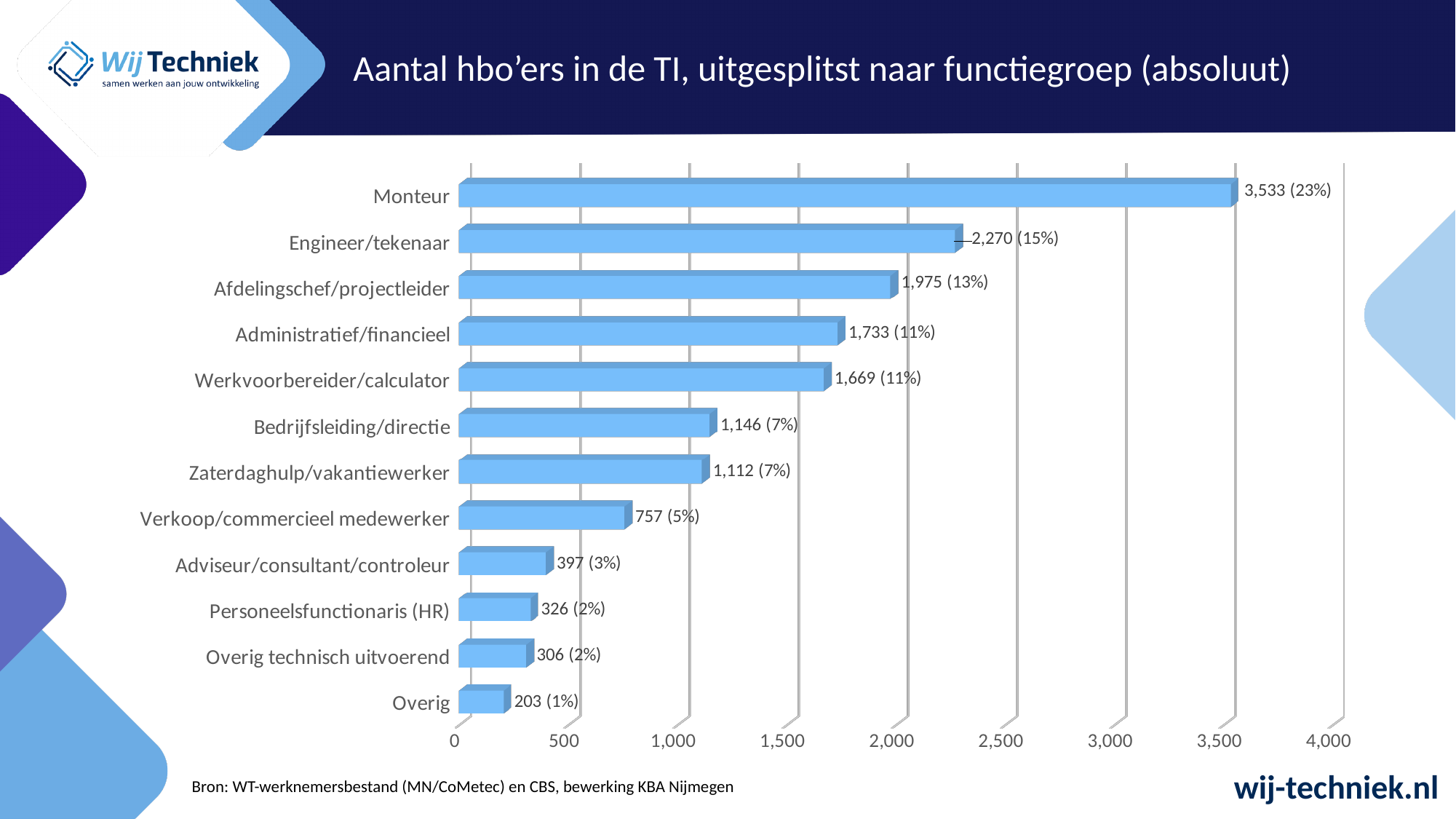
Which category has the highest value? Monteur How many categories are shown in the chart? 12 What is the difference between the values for Monteur and Engineer/tekenaar? 1,263 What is the value for Monteur? 3,533 (23%) What is the difference between the values for Verkoop/commercieel medewerker and Adviseur/consultant/controleur? 360 Which is larger, the value for Afdelingschef/projectleider or the value for Administratief/financieel? Afdelingschef/projectleider What is the title of the chart? Aantal hbo'ers in de TI, uitgesplitst naar functiegroep (absoluut) What kind of chart is shown on the slide? bar chart Is the value for Bedrijfsleiding/directie greater or less than 1,000? greater Which category has the lowest value? Overig What is the value for Personeelsfunctionaris (HR)? 326 (2%) What is the value for Werkvoorbereider/calculator? 1,669 (11%)